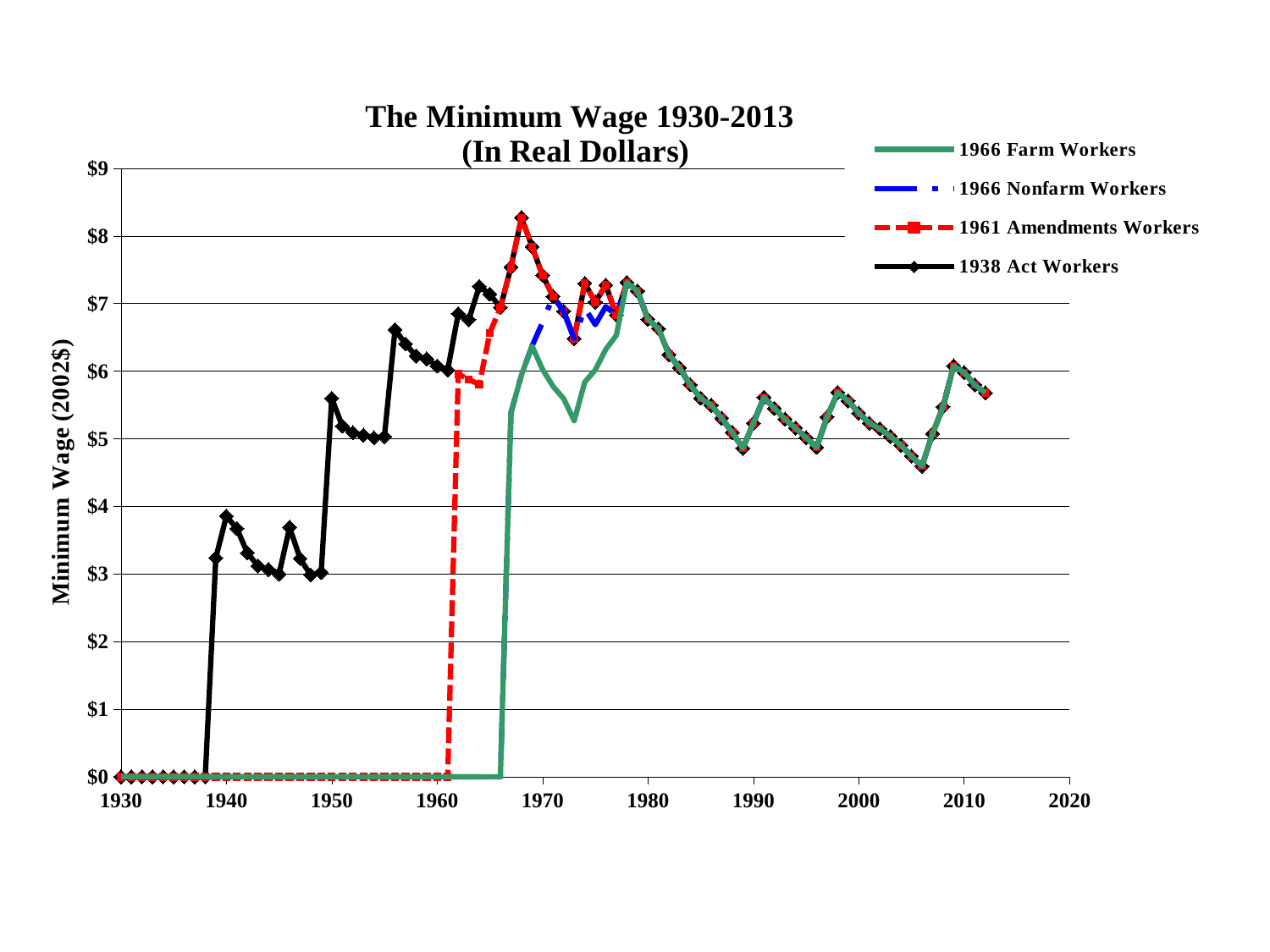
What kind of chart is shown on the slide? Line chart Is the value for 1938 Act Workers in 1940 greater or less than $3? greater How many series does the legend list? 4 What is the title of the chart? The Minimum Wage 1930-2013 (In Real Dollars) Is the value for 1938 Act Workers in 2006 greater or less than $5? less In which year does the 1938 Act Workers line reach its highest value? 1968 What is the label on the vertical axis? Minimum Wage (2002$) Is the value for 1966 Farm Workers in 1973 greater or less than $6? less Which is larger for 1938 Act Workers: the value in 1968 or the value in 1978? 1968 Does the 1938 Act Workers line rise or fall between 1980 and 1989? fall